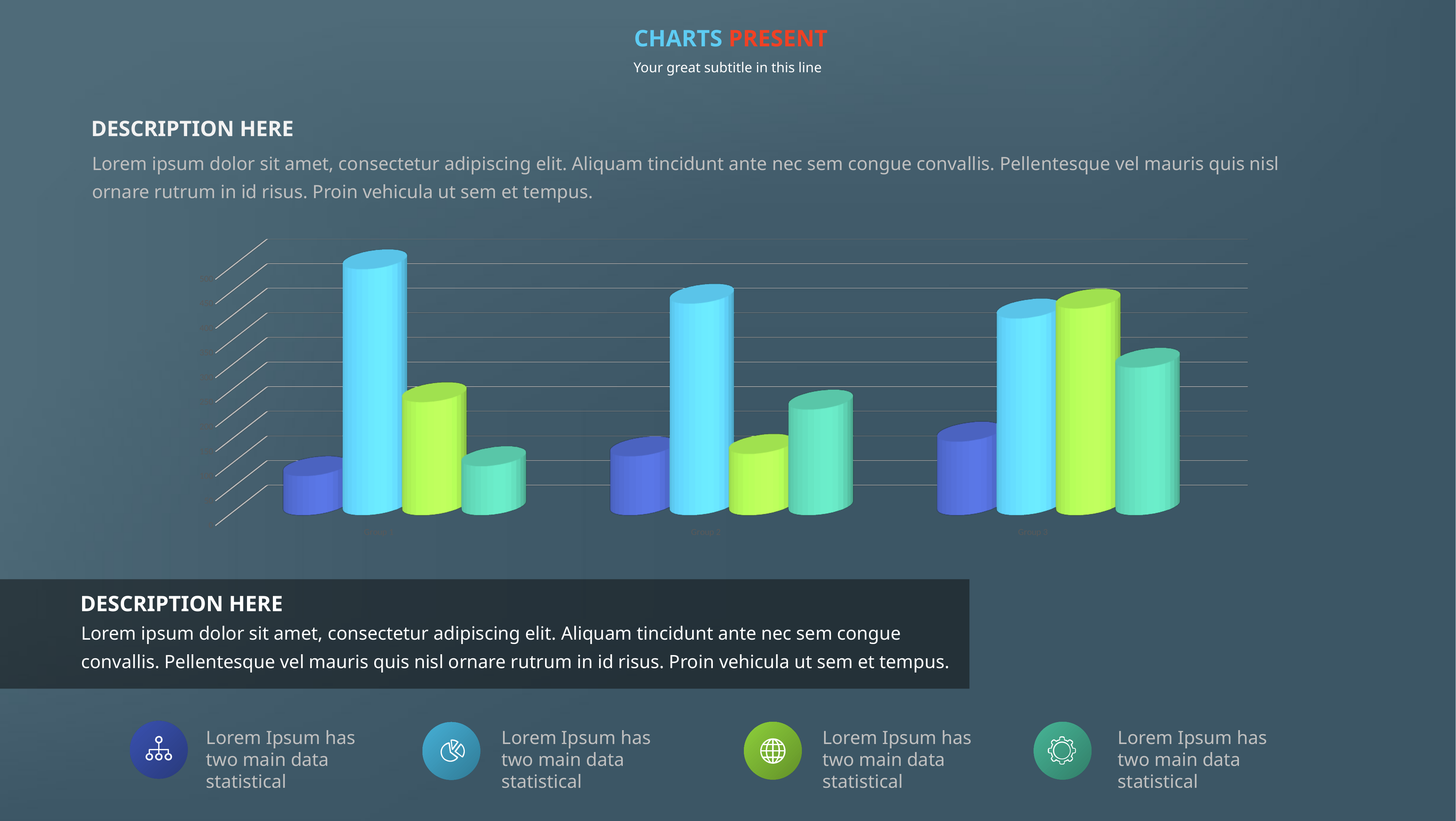
Do the dark blue bars rise or fall from the leftmost group to the rightmost group? rise What is the title shown at the top of the slide above the chart? CHARTS PRESENT How many bars are shown in each group of the chart? 4 What kind of chart is shown on the slide? bar chart In the middle group, which is taller, the light blue bar or the teal bar? the light blue bar Is the green bar taller in the leftmost group or in the rightmost group? the rightmost group In the rightmost group, which bar is the shortest? the dark blue bar Is the light blue bar taller in the leftmost group or in the middle group? the leftmost group In the leftmost group, which bar is the tallest? the light blue bar Do the light blue bars rise or fall from the leftmost group to the rightmost group? fall How many groups (categories) are plotted along the x axis of the chart? 3